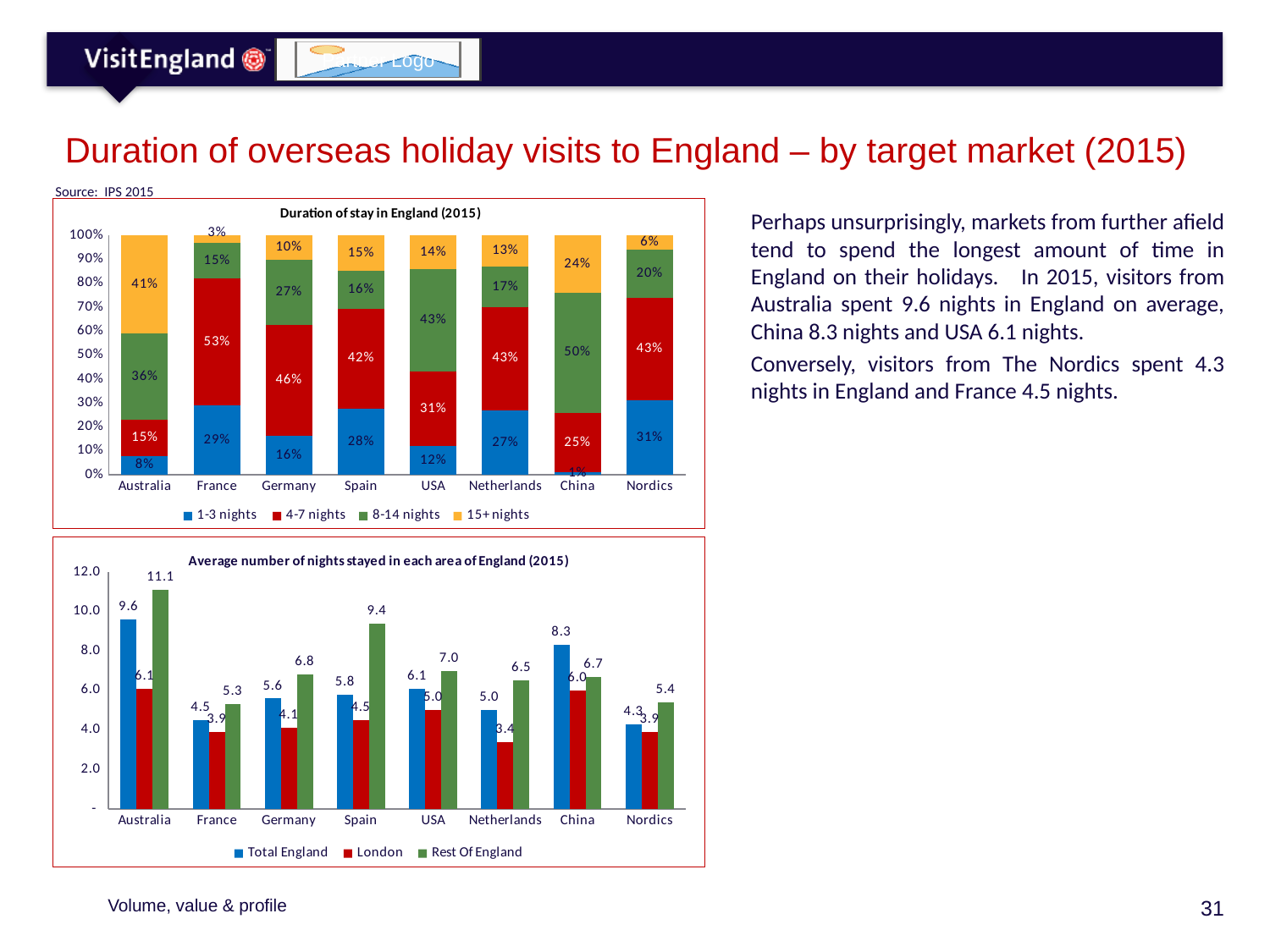
In the 'Average number of nights stayed in each area of England (2015)' chart, is the Total England value larger for Germany or for the Netherlands? Germany In the 'Average number of nights stayed in each area of England (2015)' chart, what is the difference between the Rest Of England and London values for Australia? 5.0 In the 'Average number of nights stayed in each area of England (2015)' chart, which market has the highest Rest Of England value? Australia In the 'Duration of stay in England (2015)' chart, which market has the highest share of visitors staying 8-14 nights? China In the 'Duration of stay in England (2015)' chart, what share of visitors from Australia stayed 15+ nights? 41% In the 'Average number of nights stayed in each area of England (2015)' chart, what is the Total England value for China? 8.3 In the 'Duration of stay in England (2015)' chart, what is the difference between the 1-3 nights share for the Nordics and for the USA? 19 percentage points In the 'Average number of nights stayed in each area of England (2015)' chart, which market has the lowest London value? Netherlands In the 'Average number of nights stayed in each area of England (2015)' chart, what is the Rest Of England value for Spain? 9.4 In the 'Duration of stay in England (2015)' chart, how many series does the legend list? 4 In the 'Duration of stay in England (2015)' chart, what share of visitors from France stayed 4-7 nights? 53% What type of chart is the 'Average number of nights stayed in each area of England (2015)' chart? Bar chart